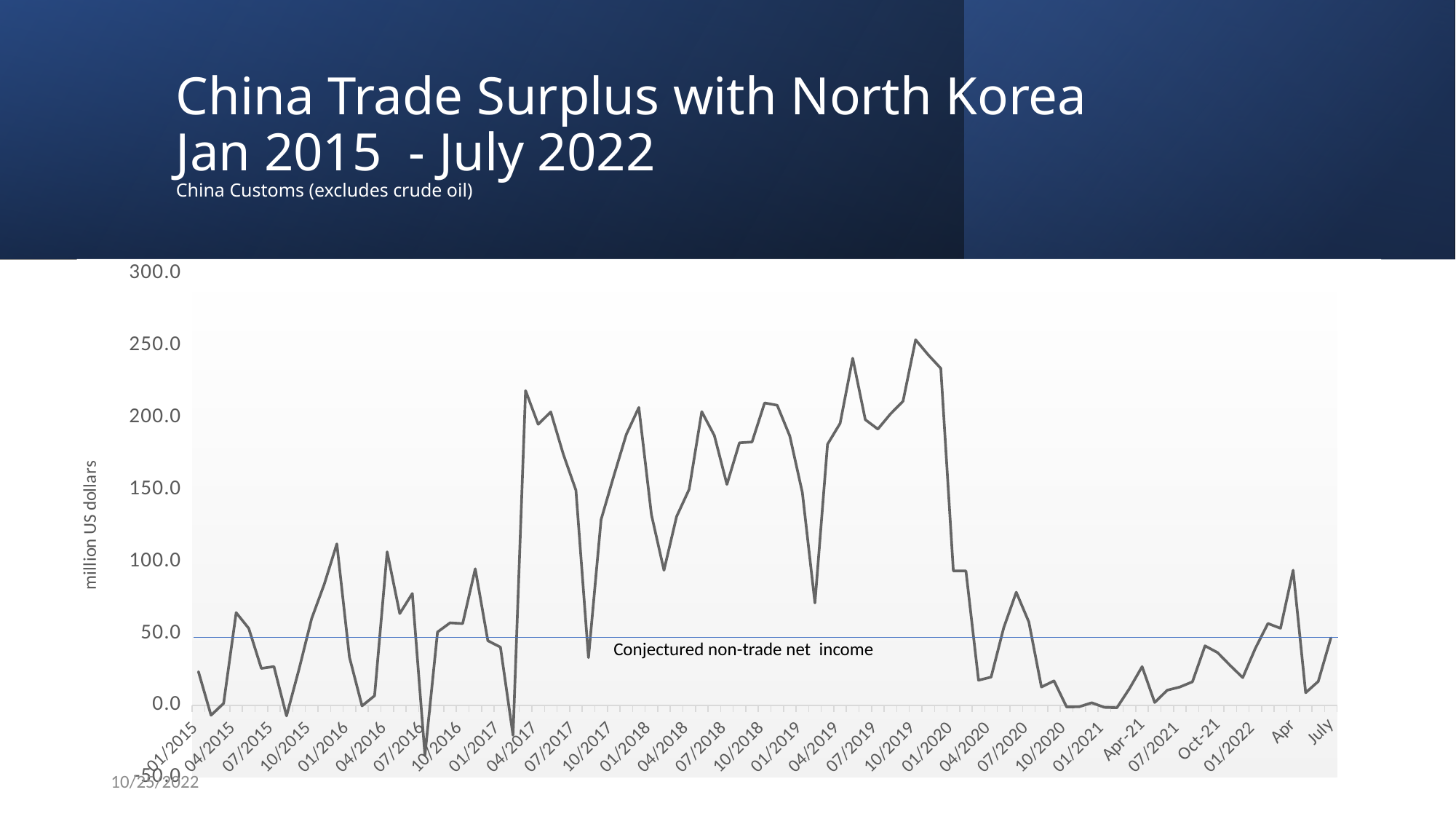
Is the value at 04/2020 greater or less than 50? less Around which x-axis label does the line reach its highest value? 10/2019 Do the values generally rise or fall between 01/2021 and Apr 2022? rise What kind of chart is shown on the slide? line chart Is the value at 01/2021 greater or less than 50? less Which is larger, the value around 10/2019 or the value at 01/2021? 10/2019 Is the value around 10/2019 greater or less than 200? greater What is the title of the chart on the slide? China Trade Surplus with North Korea Jan 2015 - July 2022 What is the label on the vertical axis of the chart? million US dollars Do the values generally rise or fall between 10/2019 and 04/2020? fall